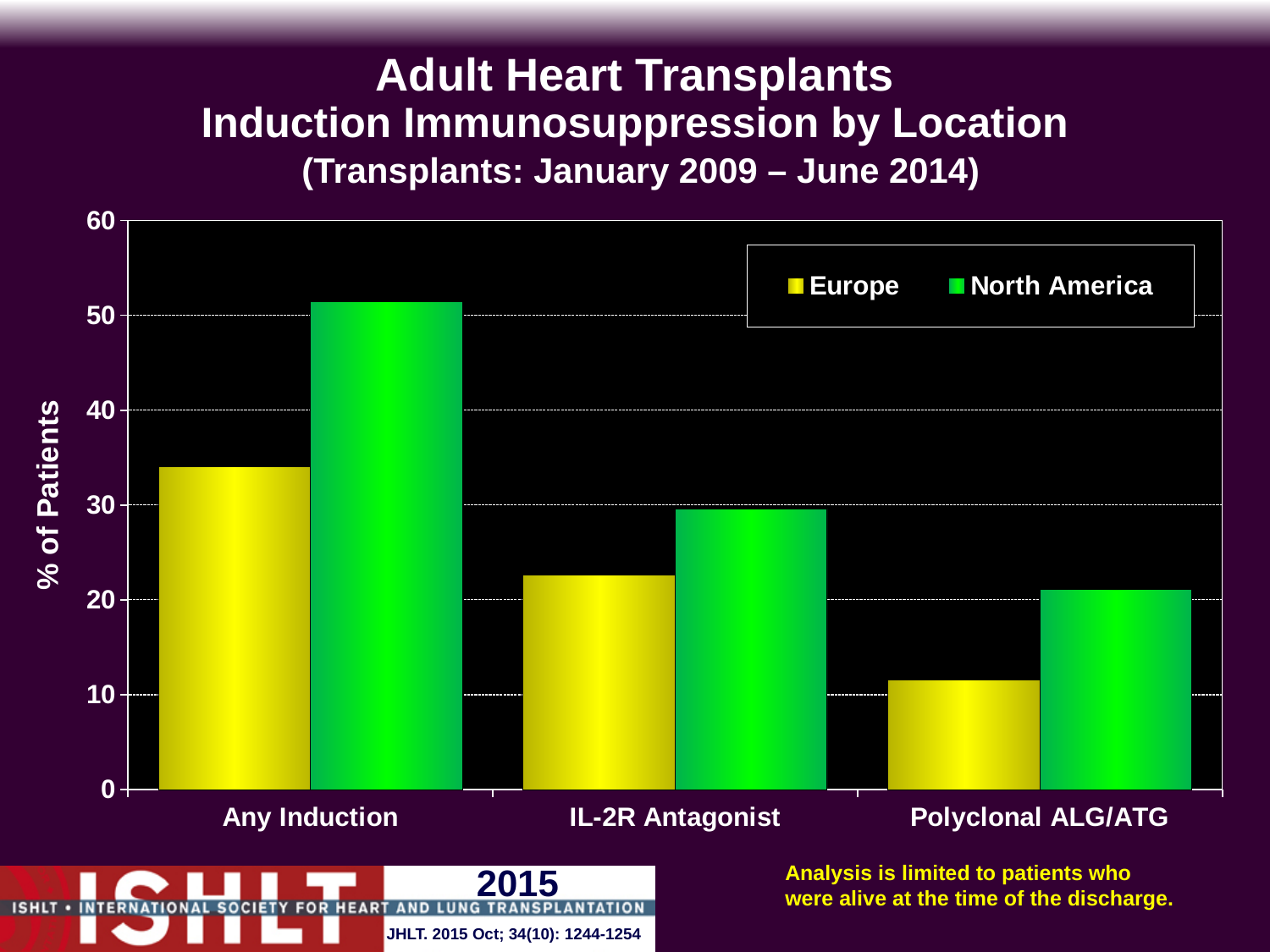
For Any Induction, which region has the larger value, Europe or North America? North America What kind of chart is shown on the slide? bar chart Which category has the lowest value for Europe? Polyclonal ALG/ATG For Polyclonal ALG/ATG, which region has the larger value, Europe or North America? North America Is the value for Europe in the Any Induction category greater or less than 30? greater How many series does the legend list? 2 Is the value for North America in the Polyclonal ALG/ATG category greater or less than 30? less Is the value for Europe in the Any Induction category greater or less than 40? less What is the label of the y axis? % of Patients How many induction categories are shown on the x axis? 3 Which category has the highest value for North America? Any Induction